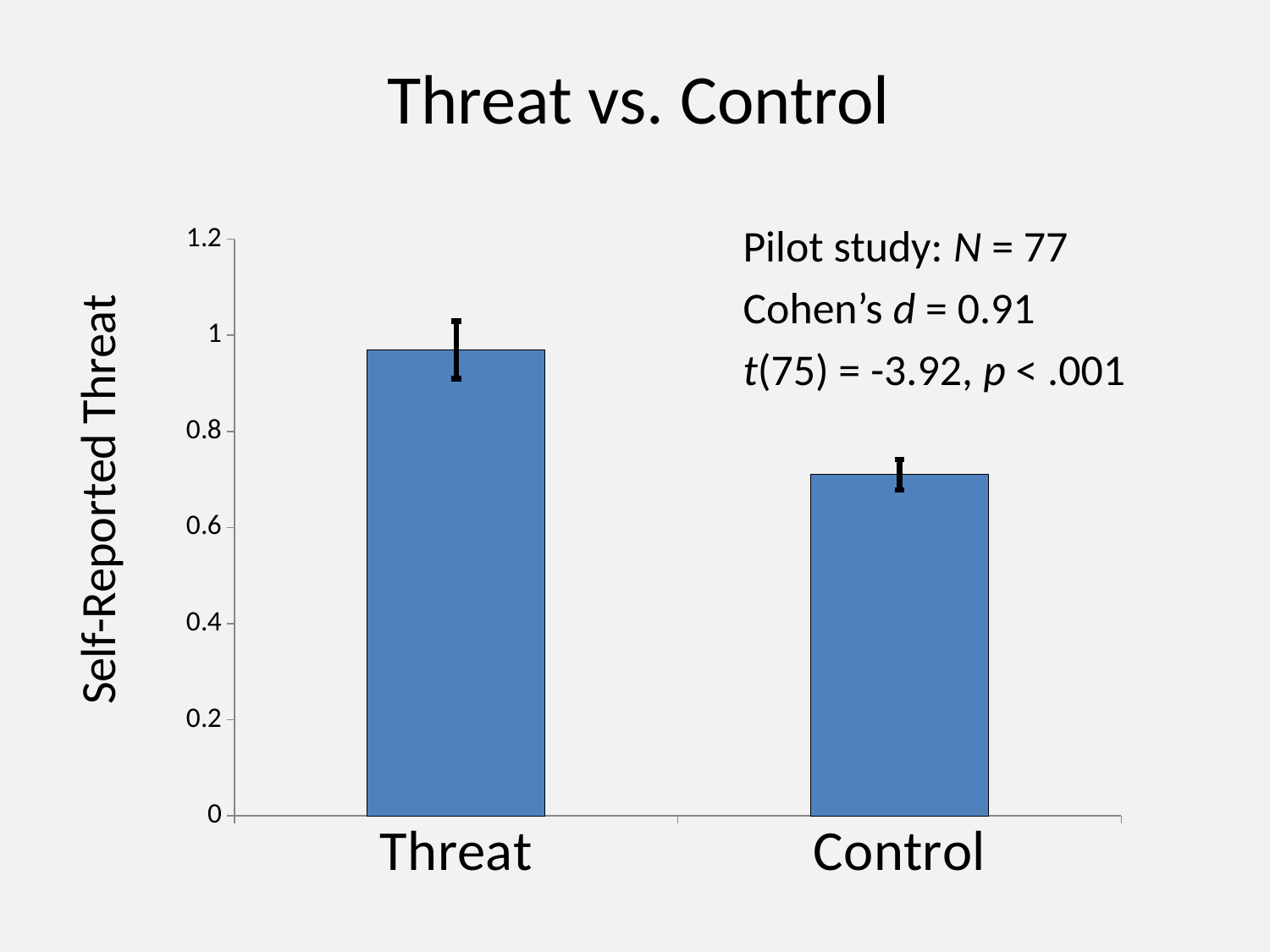
Which category has the lowest self-reported threat? Control What is the title of the chart? Threat vs. Control Which is larger, the value for Threat or the value for Control? Threat What is the label on the y axis of the chart? Self-Reported Threat Which category has the highest self-reported threat? Threat Is the value for Threat greater or less than 1.2? less Is the value for Control greater or less than 0.8? less Is the value for Threat greater or less than 0.8? greater How many bars are plotted in the chart? 2 Do the bar values rise or fall from Threat to Control along the x axis? fall What kind of chart is shown on the slide? bar chart